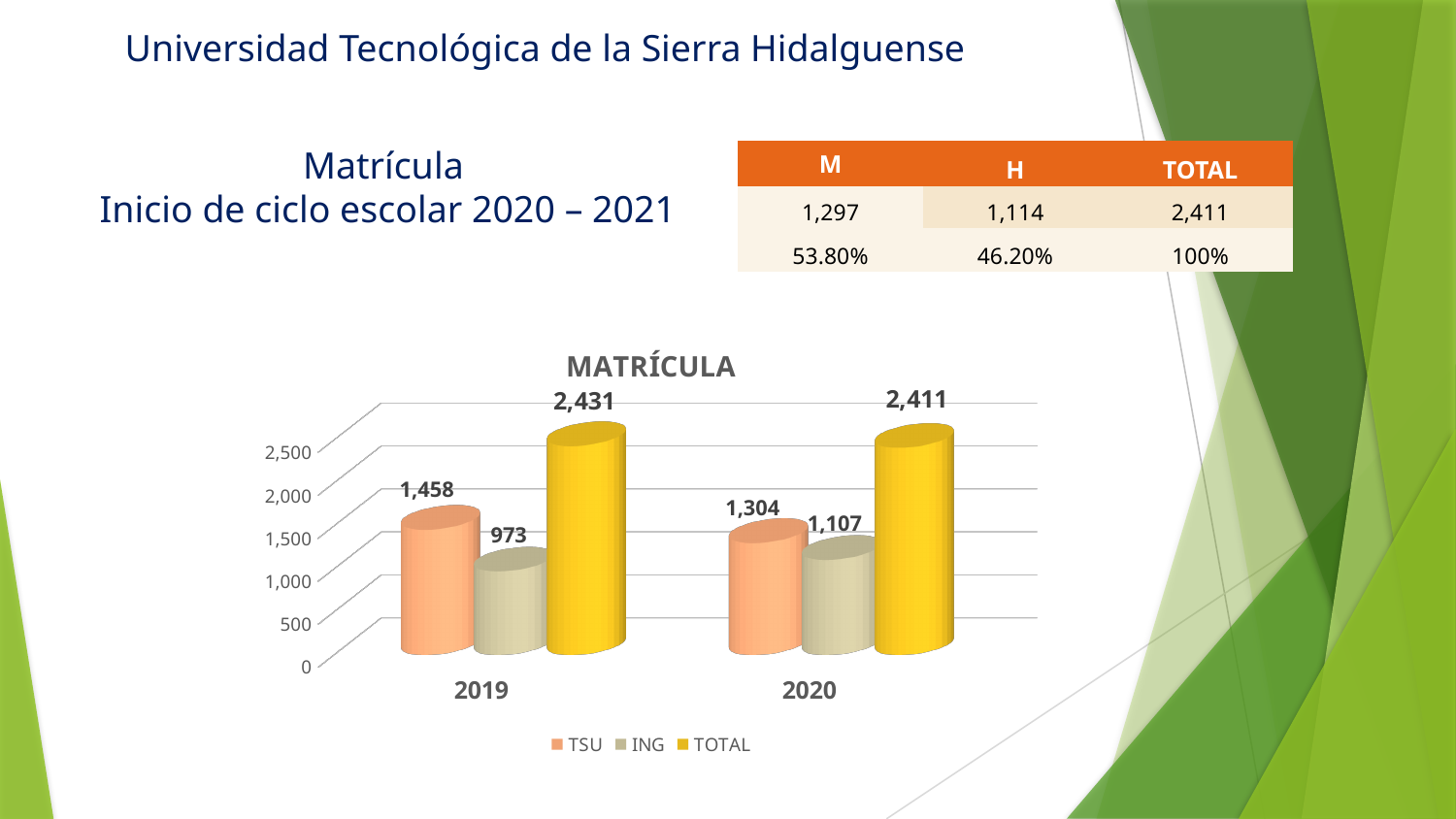
What kind of chart is shown? Bar chart What is the TOTAL value for 2020? 2,411 Which year has the higher TSU value? 2019 How many years are shown on the x axis? 2 What is the TOTAL value for 2019? 2,431 What is the difference between the TSU values for 2019 and 2020? 154 What is the title of the chart? MATRÍCULA What is the value for TSU in 2019? 1,458 What is the difference between the ING values for 2020 and 2019? 134 What is the value for ING in 2020? 1,107 How many series does the legend list? 3 Which year has the lower ING value? 2019